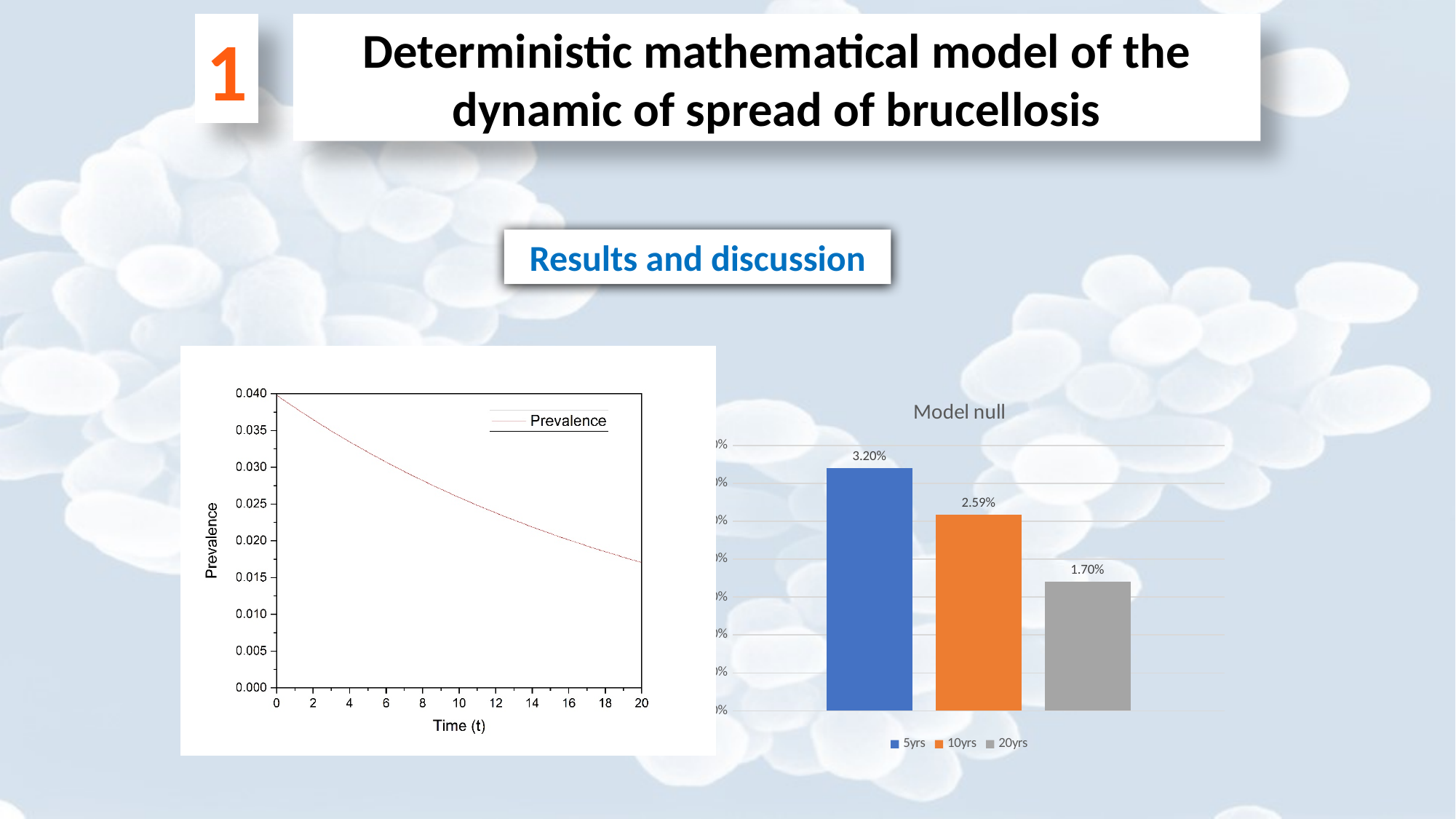
In the Prevalence chart on the left, is the prevalence at time 20 greater or less than 0.020? less What kind of chart is the Prevalence chart on the left? Line chart In the Model null chart, what is the value for 10yrs? 2.59% How many series does the legend of the Model null chart list? 3 In the Model null chart, which series has the highest value? 5yrs In the Prevalence chart on the left, does prevalence rise or fall as time increases from 0 to 20? Fall In the Model null chart, which series has the lowest value? 20yrs In the Model null chart, which is larger, the 10yrs value or the 20yrs value? 10yrs In the Model null chart, what is the difference between the 5yrs and 20yrs values? 1.50% What kind of chart is the Model null chart on the right? Bar chart In the Model null chart, what is the value for 20yrs? 1.70% In the Model null chart, what is the value for 5yrs? 3.20%